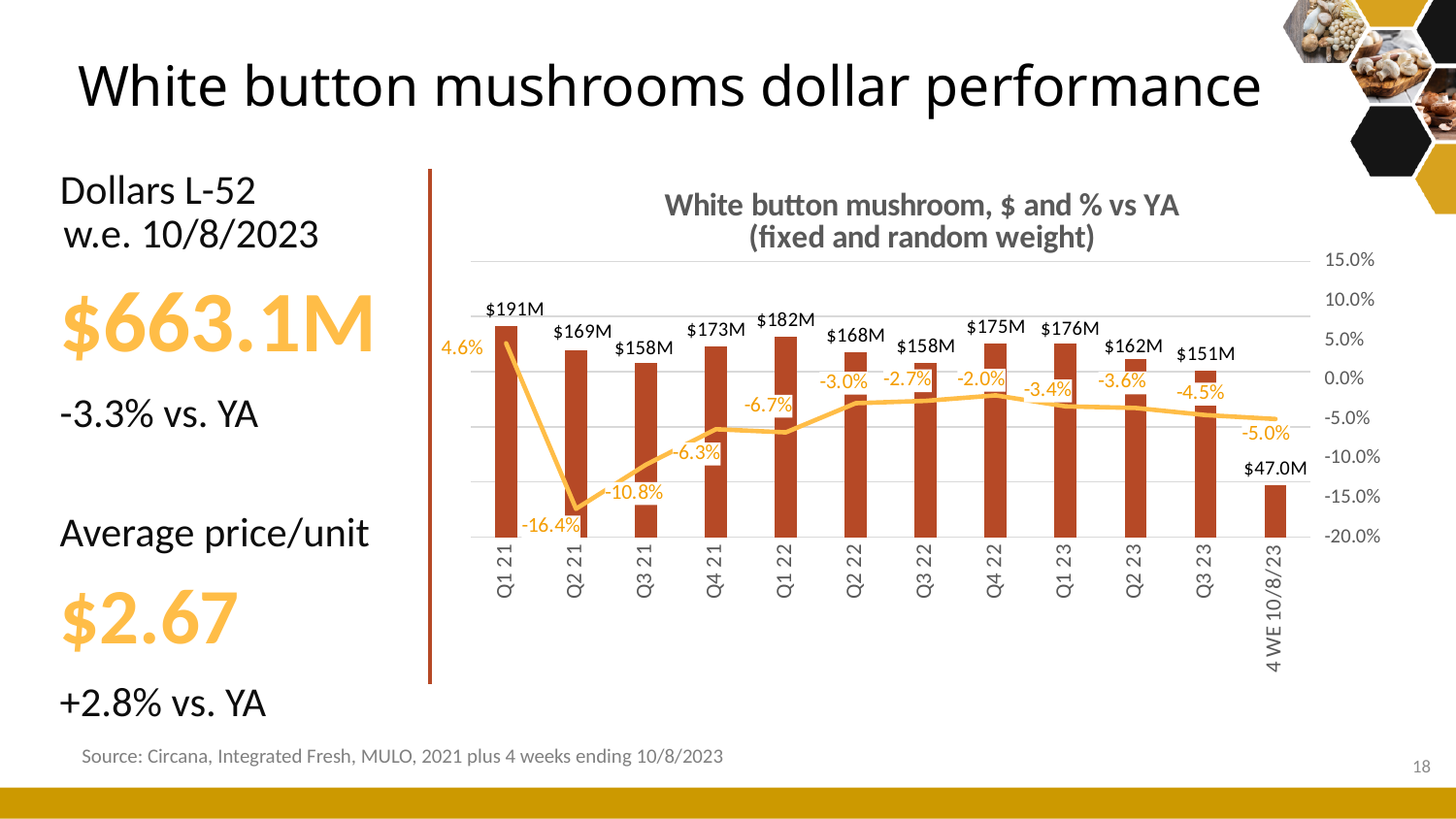
What kind of chart is this? Combination bar and line chart What is the dollar value shown for Q1 21? $191M How many periods are plotted along the x axis? 12 What is the % vs YA value shown for Q3 23? -4.5% What is the dollar value shown for the 4 WE 10/8/2023 period? $47.0M Which has the larger dollar value, Q1 22 or Q2 22? Q1 22 Which period has the lowest % vs YA value on the line? Q2 21 What is the title of the chart? White button mushroom, $ and % vs YA (fixed and random weight) Does the % vs YA line rise or fall from Q2 21 to Q4 22? Rise Which quarter has the highest dollar value among the bars? Q1 21 What is the difference in dollar value between Q1 22 and Q4 21? $9M What is the % vs YA value shown for Q2 21? -16.4%